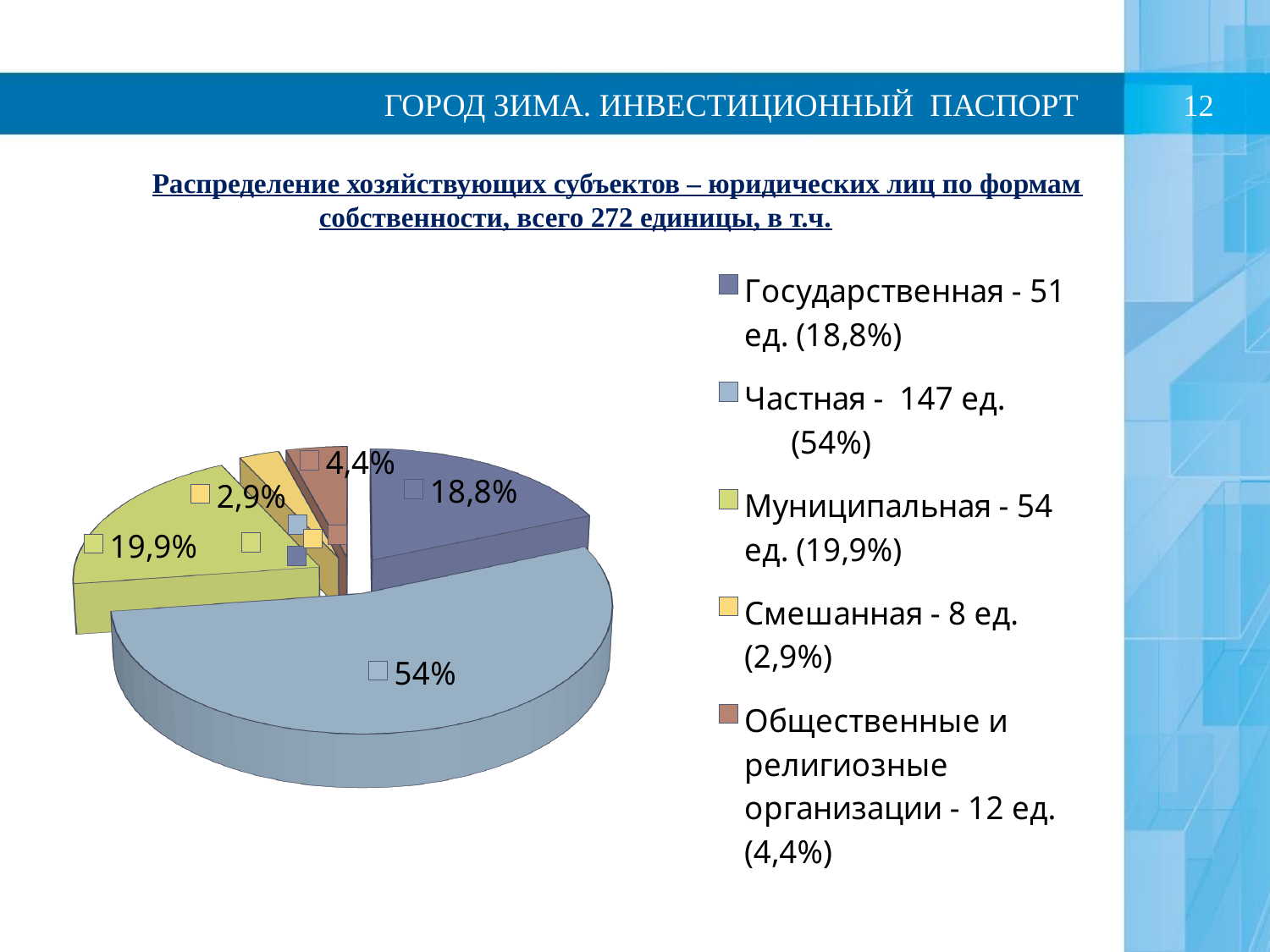
What kind of chart is shown on the slide? pie chart How many slices does the pie chart have? 5 What share of the pie does the Государственная slice represent? 18,8% What share of the pie does the Муниципальная slice represent? 19,9% How many units (ед.) does the legend give for Частная? 147 ед. How many units (ед.) does the legend give for Общественные и религиозные организации? 12 ед. What share of the pie does the Смешанная slice represent? 2,9% Which category has the largest slice of the pie? Частная Which is larger, the Муниципальная slice or the Государственная slice? Муниципальная What is the difference in percentage points between the Частная slice and the Муниципальная slice? 34,1 Which category has the smallest slice of the pie? Смешанная